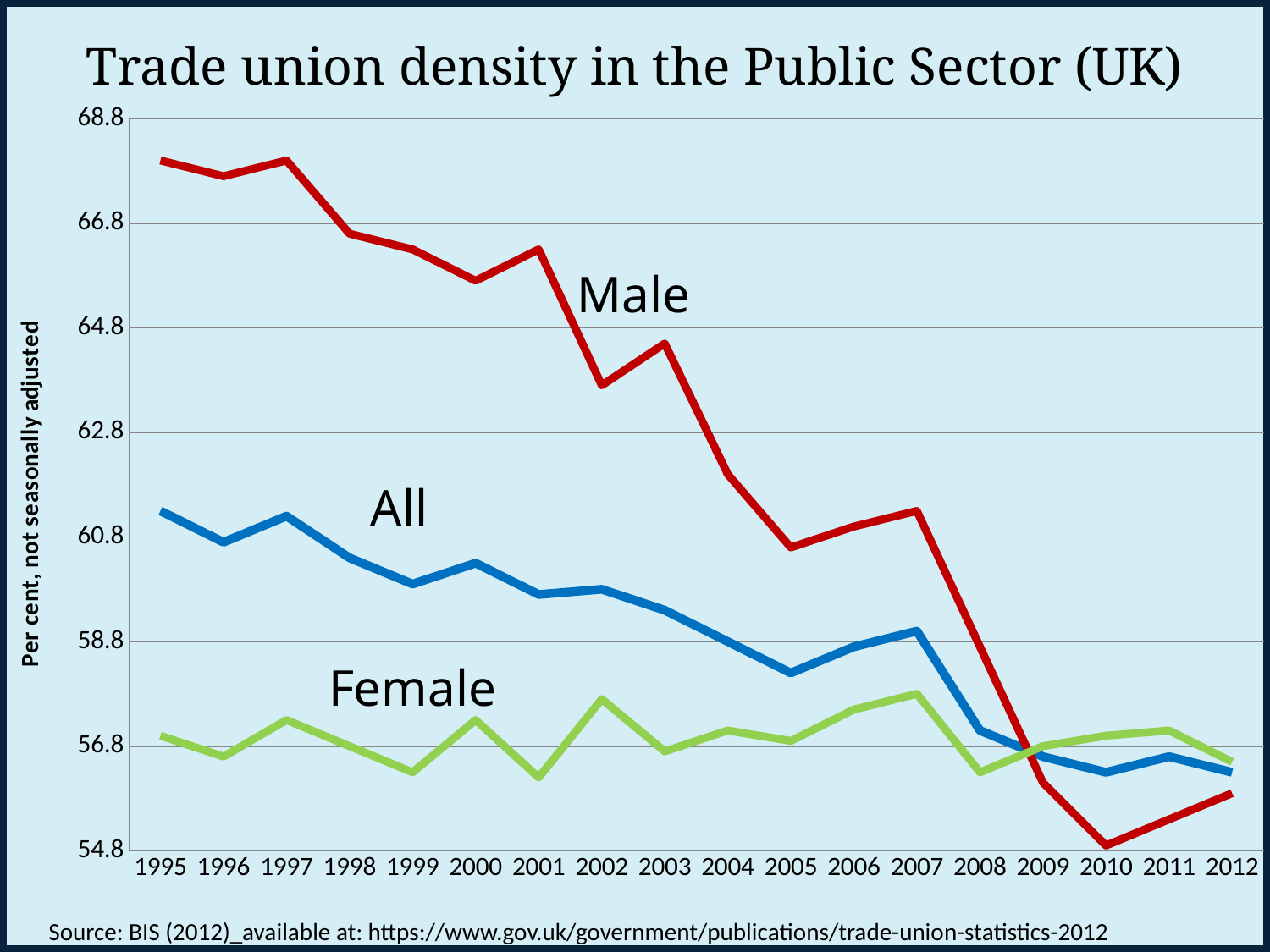
Is the value for All in 2005 greater or less than 58.8? less Is the value for Male in 2010 greater or less than 56.8? less Does the Male series generally rise or fall from 1995 to 2012? Fall What kind of chart is shown on the slide? Line chart Is the value for Male in 1995 greater or less than 66.8? greater Which series is drawn in green? Female In which year is the Male series at its lowest? 2010 In 1995, which is larger, the Male value or the Female value? Male What is the title of the chart? Trade union density in the Public Sector (UK) How many series are plotted on the chart? 3 How many years are shown along the x axis? 18